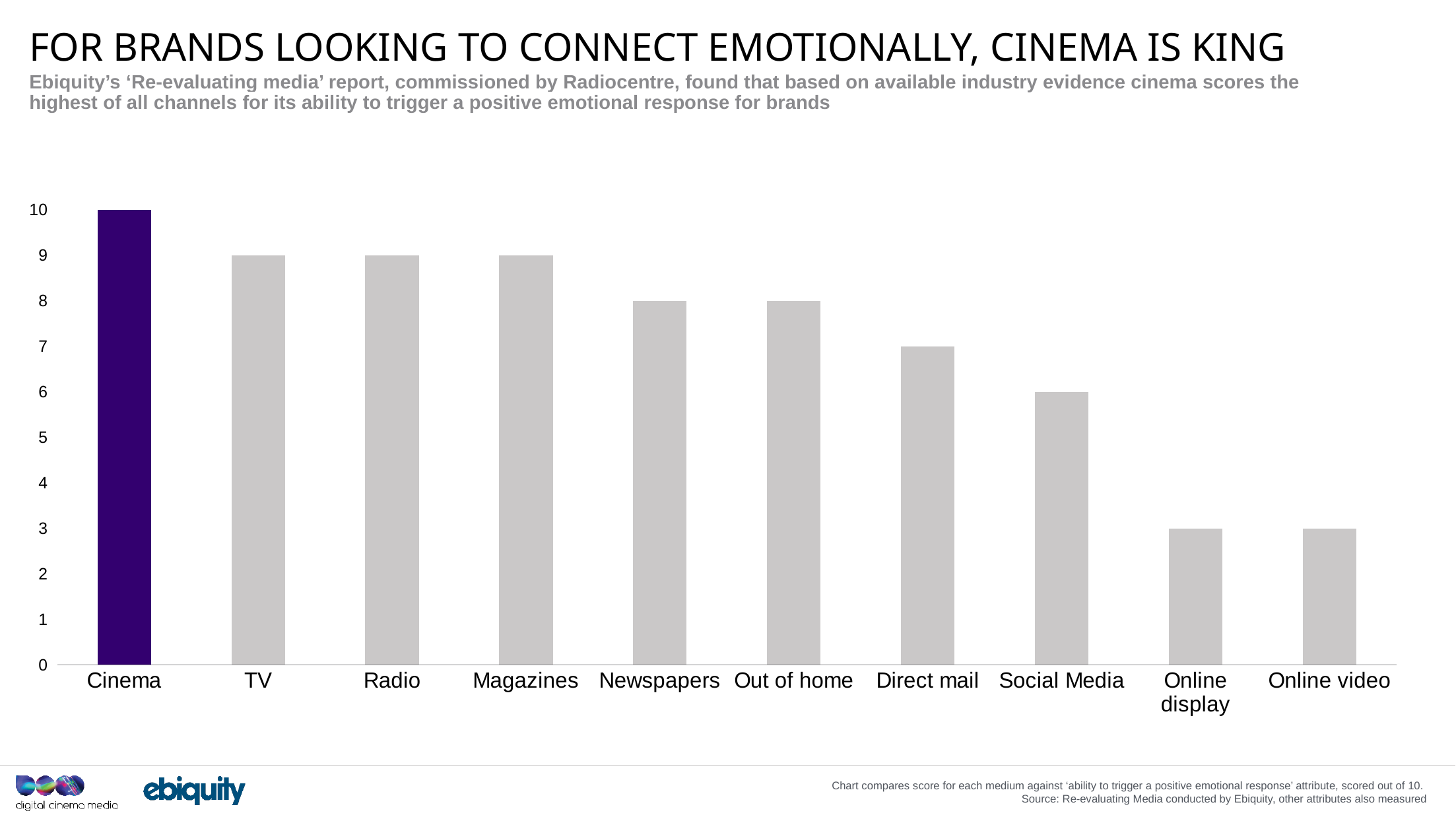
What kind of chart is shown on the slide? bar chart Is the value for Direct mail greater or less than 5? greater What is the value for Cinema? 10 What is the value for Social Media? 6 Which is larger, the value for Magazines or the value for Out of home? Magazines Which category has the highest value? Cinema Which bar is coloured differently from the others? Cinema What is the difference between the values for Cinema and Social Media? 4 What is the value for Direct mail? 7 What is the value for Newspapers? 8 How many categories are shown on the x axis? 10 What is the difference between the values for TV and Online display? 6